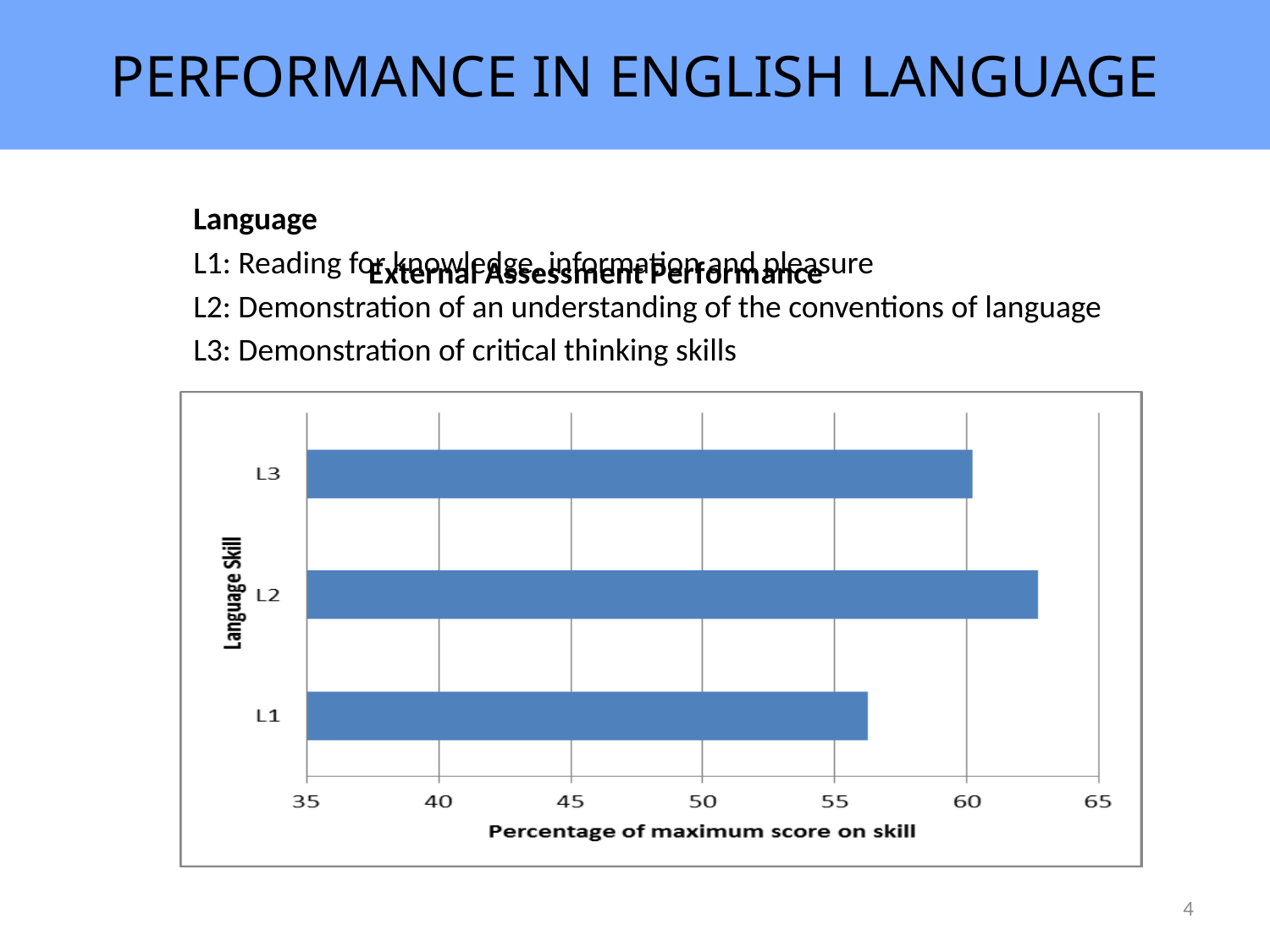
Is the value for L3 greater or less than 65? less Is the value for L2 greater or less than 60? greater How many language skill categories are plotted in the chart? 3 Is the value for L1 greater or less than 55? greater Which language skill has the highest percentage of maximum score? L2 Which language skill has the lowest percentage of maximum score? L1 What is the label of the vertical axis of the chart? Language Skill What is the label of the horizontal axis of the chart? Percentage of maximum score on skill Which has a higher percentage of maximum score, L2 or L3? L2 What kind of chart is shown on the slide? bar chart Which has a higher percentage of maximum score, L3 or L1? L3